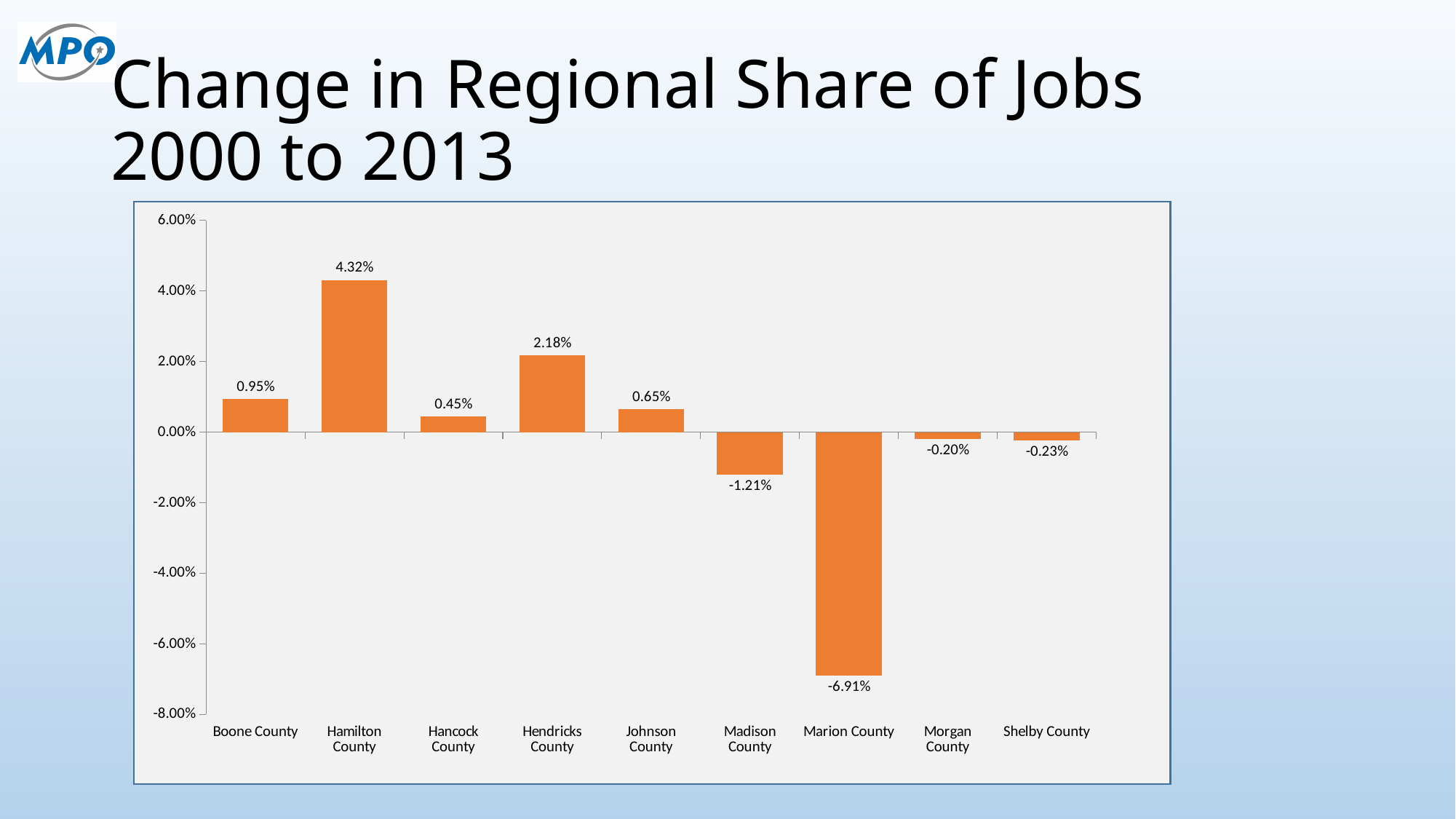
What is the change in regional share of jobs for Hamilton County? 4.32% What kind of chart is shown on the slide? Bar chart Which has a larger value, Boone County or Johnson County? Boone County What is the title of the slide? Change in Regional Share of Jobs 2000 to 2013 What is the difference between the values for Hamilton County and Hendricks County? 2.14% What is the value shown for Hendricks County? 2.18% What is the value shown for Marion County? -6.91% Is the value for Marion County greater or less than -6.00%? less What is the value shown for Madison County? -1.21% Which county has the lowest change in regional share of jobs? Marion County How many counties are shown on the chart? 9 Which county has the highest change in regional share of jobs? Hamilton County